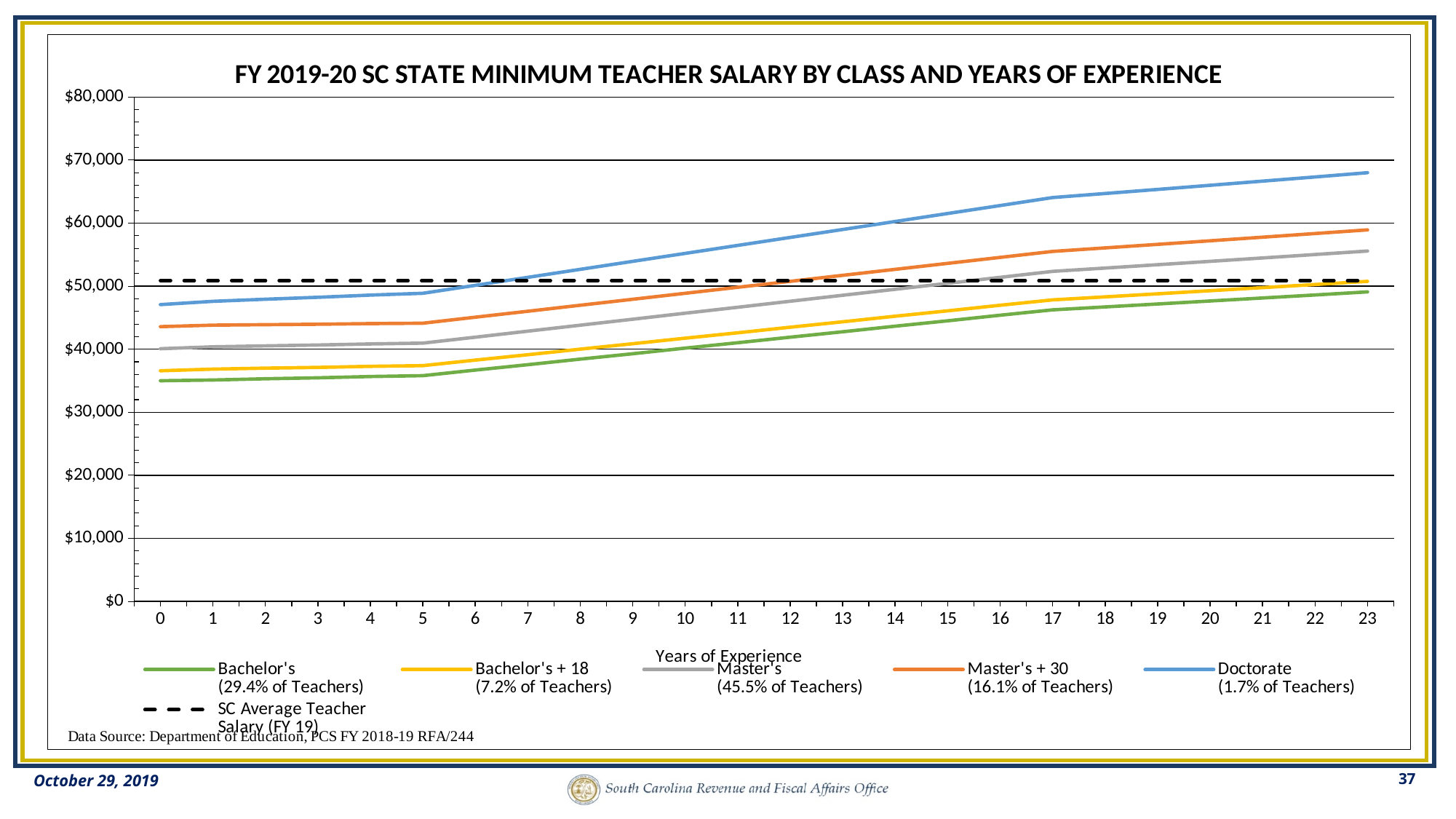
According to the legend, what percentage of teachers hold a Master's? 45.5% of Teachers Which salary class has the lowest minimum salary at 0 years of experience? Bachelor's What does the black dashed line in the chart represent? SC Average Teacher Salary (FY 19) Is the Doctorate minimum salary at 0 years of experience greater or less than $50,000? less Which salary class has the highest minimum salary at 23 years of experience? Doctorate What kind of chart is shown on the slide? Line chart How many entries does the chart legend list? 6 At 10 years of experience, which is higher: the Master's line or the Bachelor's + 18 line? Master's Is the Doctorate minimum salary at 23 years of experience greater or less than $60,000? greater Do the minimum salary lines rise or fall as years of experience increase? Rise How many years of experience values are shown on the x axis? 24 Is the Bachelor's minimum salary at 0 years of experience greater or less than $40,000? less